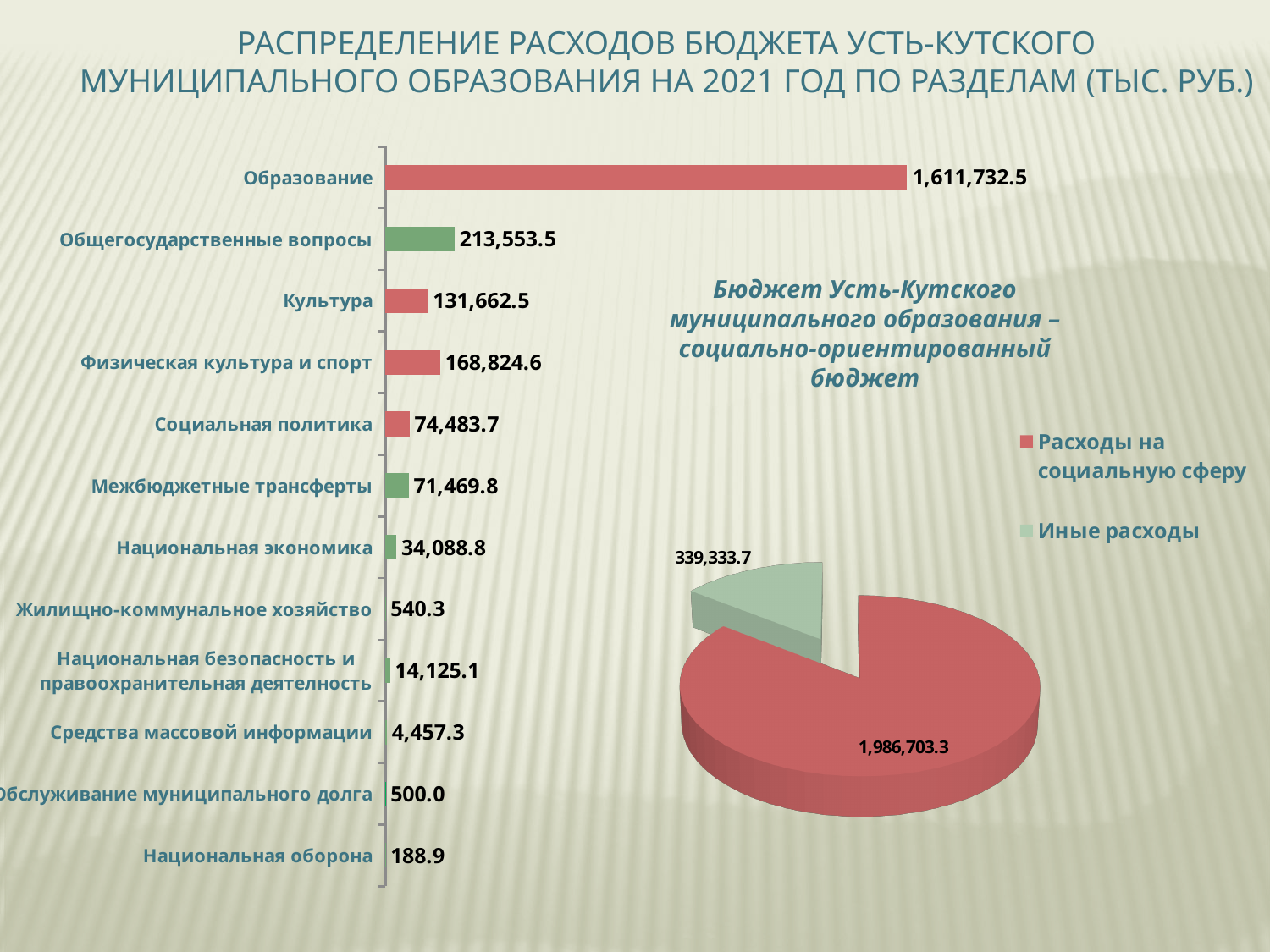
On the bar chart, which is larger: Физическая культура и спорт or Культура? Физическая культура и спорт On the pie chart, what is the value for Иные расходы? 339,333.7 On the bar chart, what is the difference between Образование and Общегосударственные вопросы? 1,398,179.0 On the bar chart, what is the value for Межбюджетные трансферты? 71,469.8 What kind of chart is the chart on the left of the slide? Bar chart On the pie chart, what is the value for Расходы на социальную сферу? 1,986,703.3 On the bar chart, what is the value for Национальная безопасность и правоохранительная деятельность? 14,125.1 On the bar chart, which category has the highest value? Образование How many categories does the bar chart show? 12 How many entries does the legend of the pie chart list? 2 On the bar chart, which category has the lowest value? Национальная оборона On the bar chart, what is the value for Образование? 1,611,732.5